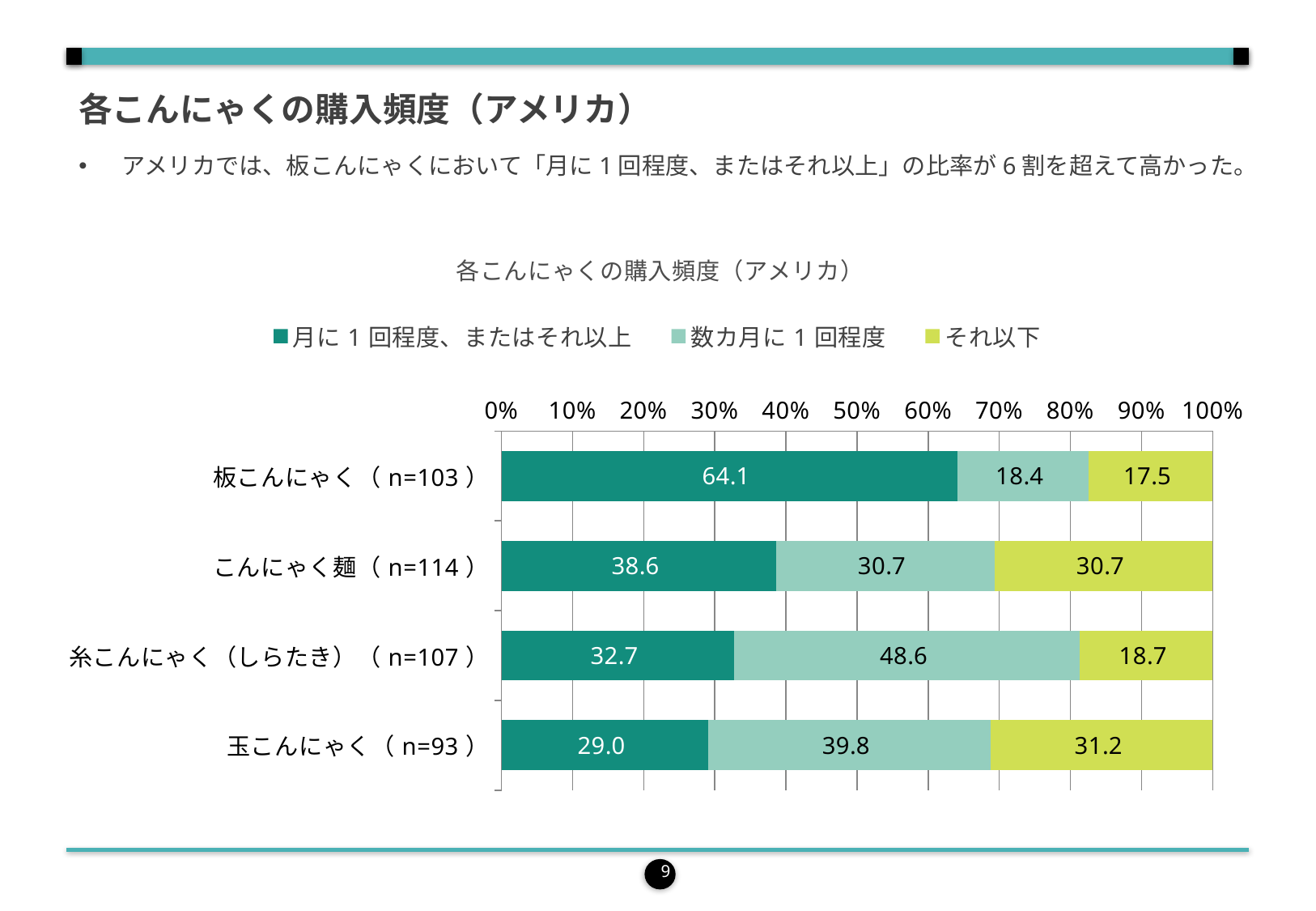
Which is larger: それ以下 for こんにゃく麺（n=114） or それ以下 for 糸こんにゃく（しらたき）（n=107）? こんにゃく麺（n=114） What is the value of 月に１回程度、またはそれ以上 for 板こんにゃく（n=103）? 64.1 What is the value of 数カ月に１回程度 for 糸こんにゃく（しらたき）（n=107）? 48.6 What is the value of それ以下 for 玉こんにゃく（n=93）? 31.2 What is the difference between the 月に１回程度、またはそれ以上 values for 板こんにゃく（n=103） and こんにゃく麺（n=114）? 25.5 Which category has the highest value for 月に１回程度、またはそれ以上? 板こんにゃく（n=103） What is the title of the chart? 各こんにゃくの購入頻度（アメリカ） What is the total of the stacked bar for 玉こんにゃく（n=93）? 100.0 How many series does the legend list? 3 What kind of chart is shown on the slide? Stacked bar chart Which category has the lowest value for 月に１回程度、またはそれ以上? 玉こんにゃく（n=93） How many categories are shown on the chart? 4